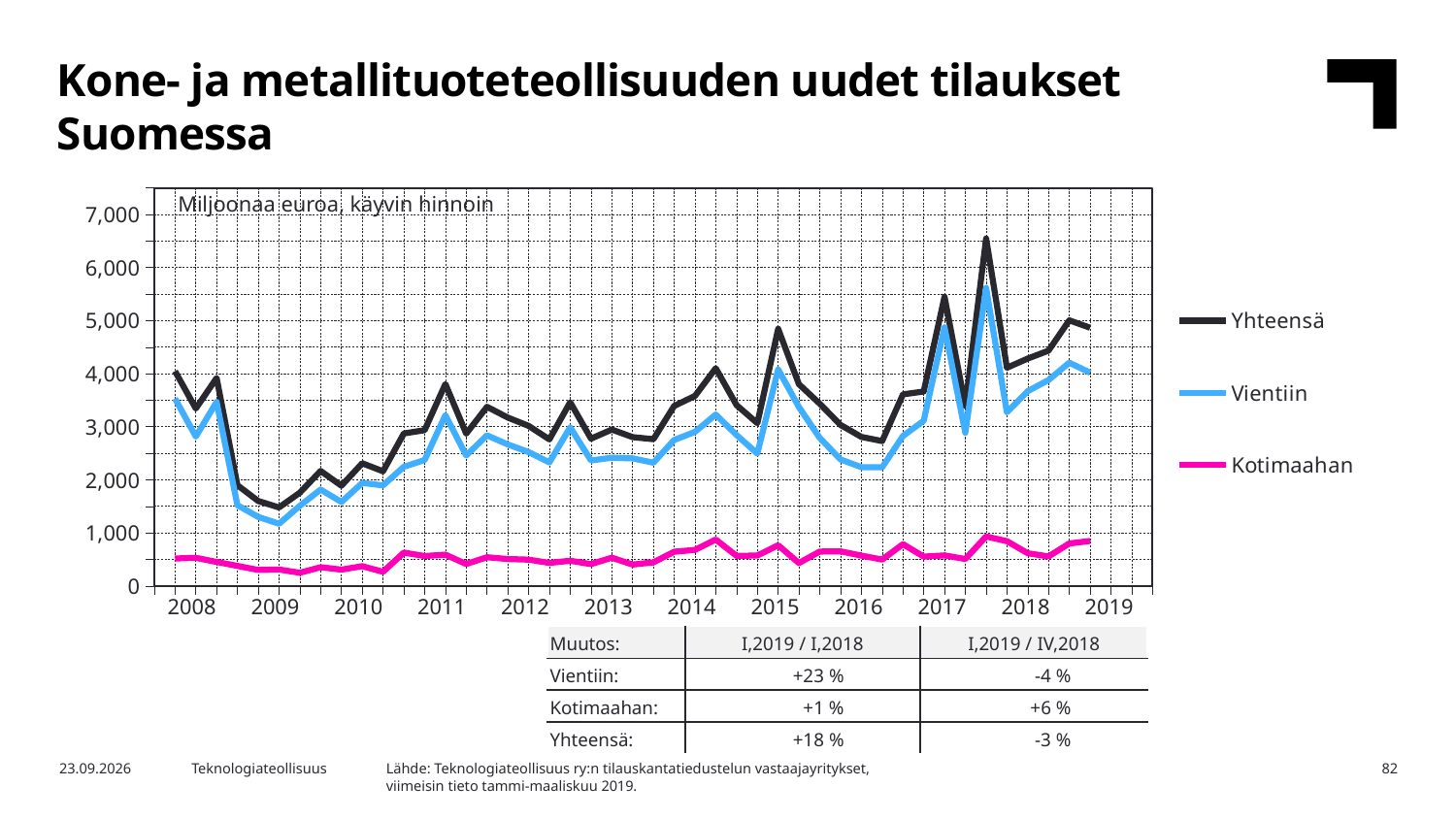
What unit is stated in the label at the top of the chart? Miljoonaa euroa, käyvin hinnoin Is the peak value of Yhteensä in 2017 greater or less than 6,000? greater Is the value for Kotimaahan ever greater or less than 1,000 over the period shown? less Which series is larger in 2018, Vientiin or Kotimaahan? Vientiin What kind of chart is shown on the slide? line chart Do the Yhteensä values rise or fall from 2009 to 2011? rise How many series does the legend list? 3 Is the peak value of Vientiin in 2017 greater or less than 5,000? greater How many year labels are shown on the x axis? 12 Which series reaches the highest value on the chart? Yhteensä Which series is plotted lowest across the whole chart? Kotimaahan